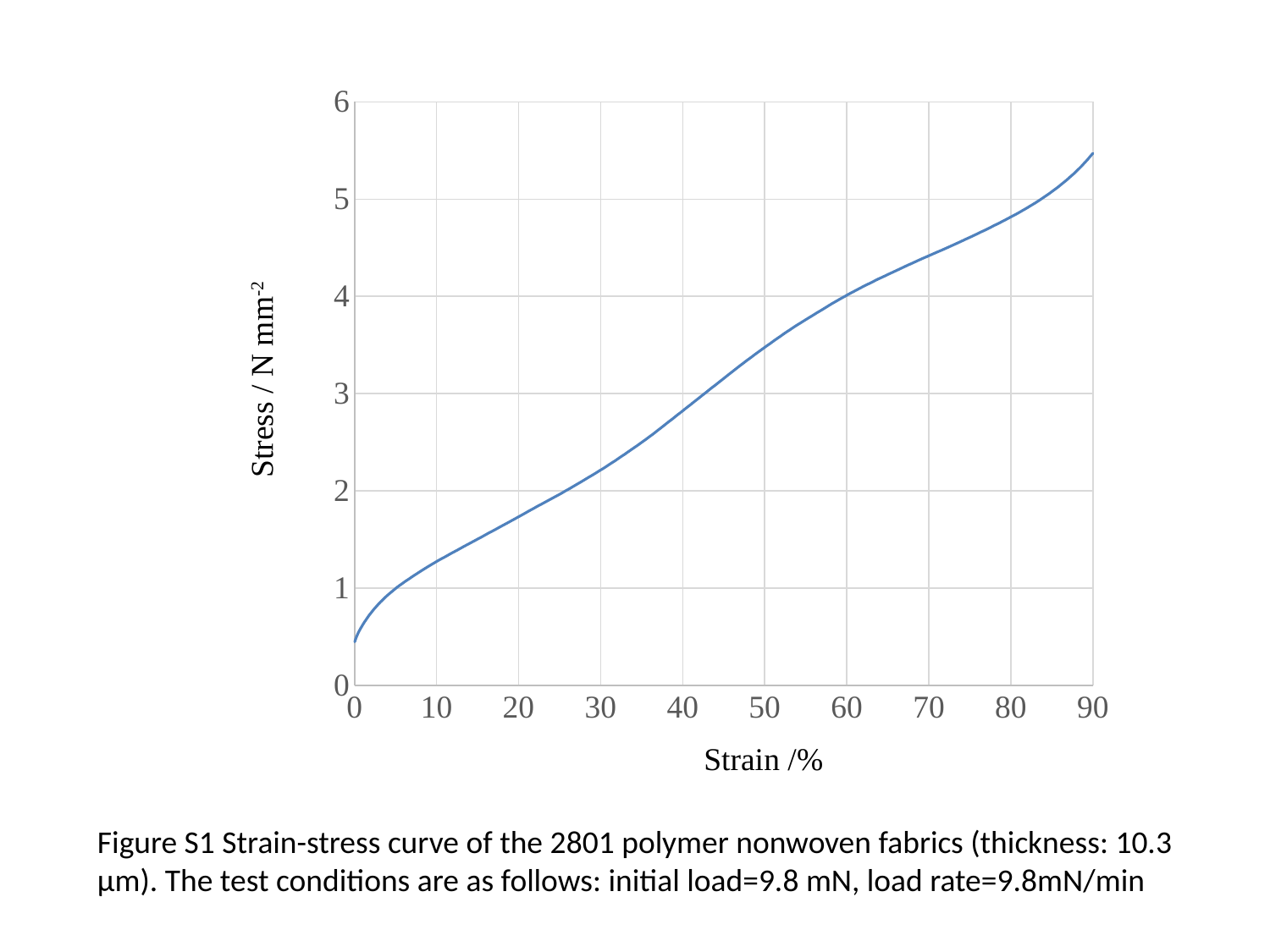
Is the stress at a strain of 40% greater or less than 3? less Is the stress at a strain of 0% greater or less than 1? less Does the stress rise or fall as strain increases from 0 to 90%? rise Is the stress at a strain of 70% greater or less than 4? greater At which strain value shown on the x axis is the stress highest? 90 What is the label of the x axis? Strain /% At which strain value shown on the x axis is the stress lowest? 0 What kind of chart is shown on the slide? line chart Which is larger, the stress at a strain of 20% or the stress at a strain of 60%? 60%